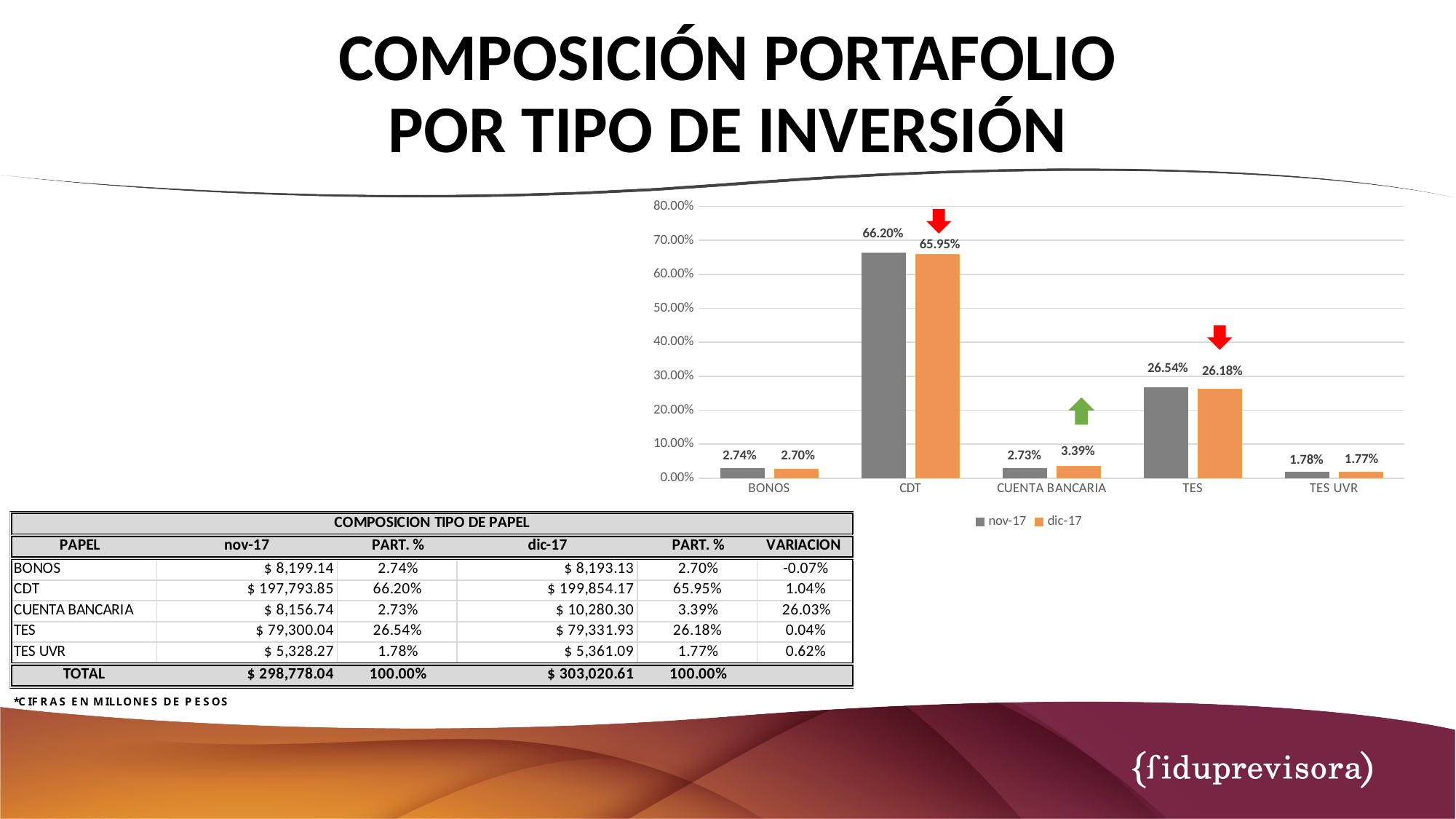
How many series does the chart's legend list? 2 How many categories are shown on the x axis of the chart? 5 Is the dic-17 value for CDT in the chart greater or less than 60.00%? greater What is the dic-17 value for TES UVR in the chart? 1.77% What kind of chart is shown on the slide? bar chart What is the difference between the nov-17 and dic-17 values for TES in the chart? 0.36% What is the dic-17 value for CUENTA BANCARIA in the chart? 3.39% What is the nov-17 value for CDT in the chart? 66.20% Which is larger for CUENTA BANCARIA in the chart: the nov-17 value or the dic-17 value? dic-17 Which series in the chart is shown in orange? dic-17 Which category has the highest dic-17 value in the chart? CDT Which category has the lowest nov-17 value in the chart? TES UVR